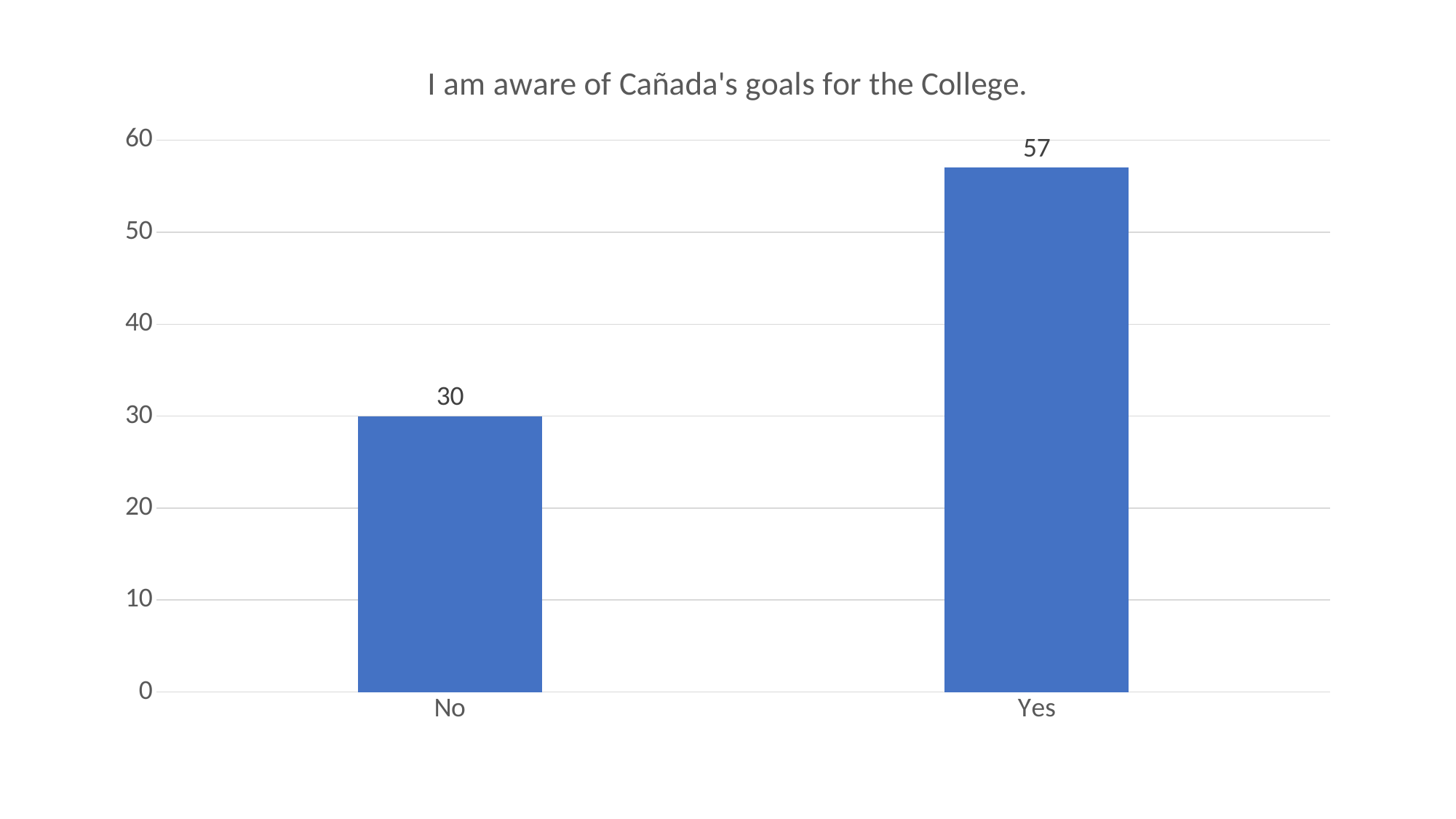
Which is larger, the value for "Yes" or the value for "No"? Yes Is the value for "Yes" greater or less than 50? greater How many categories are shown on the x axis? 2 What is the value for "No"? 30 What is the value for "Yes"? 57 Which category has the lowest value? No Which category has the highest value? Yes What is the difference between the values for "Yes" and "No"? 27 What kind of chart is shown on the slide? bar chart Is the value for "No" greater or less than 40? less What is the highest value shown on the y axis? 60 What is the title of the chart? I am aware of Cañada's goals for the College.